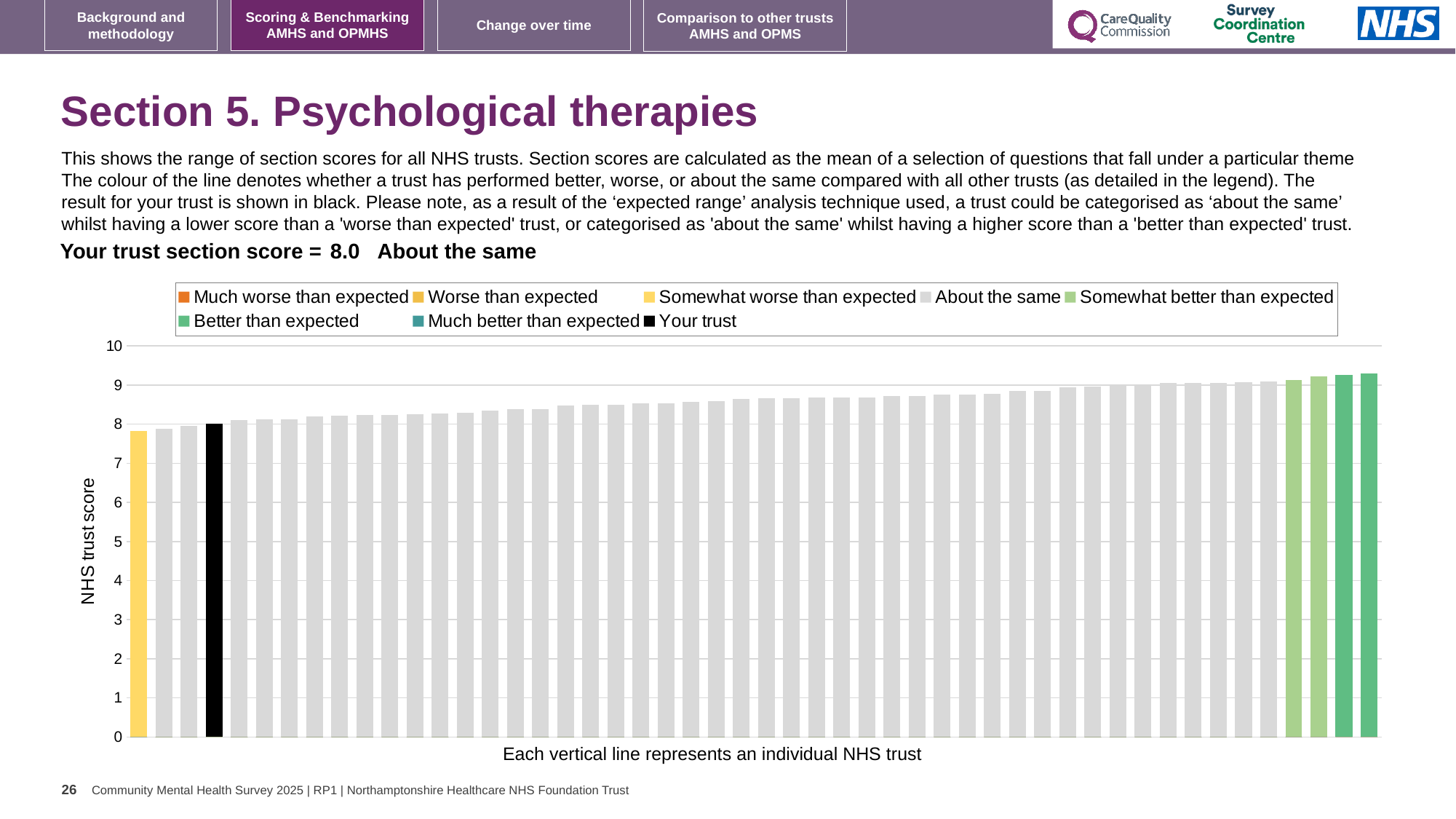
What is the section score for your trust shown on the slide? 8.0 Which legend category does the lowest-scoring trust belong to? Somewhat worse than expected Do the bar values rise or fall from left to right along the x axis? Rise How many entries does the chart legend list? 8 Which legend category does the highest-scoring trust belong to? Better than expected Is the value of the rightmost (highest) bar greater or less than 10? less How many bars are coloured as 'Better than expected' (dark green)? 2 Is the value of the leftmost (lowest) bar greater or less than 7? greater Is the value for your trust (the black bar) greater or less than 5? greater What is the label on the vertical axis of the chart? NHS trust score What kind of chart is shown on the slide? Bar chart Which benchmarking category is your trust placed in for this section? About the same